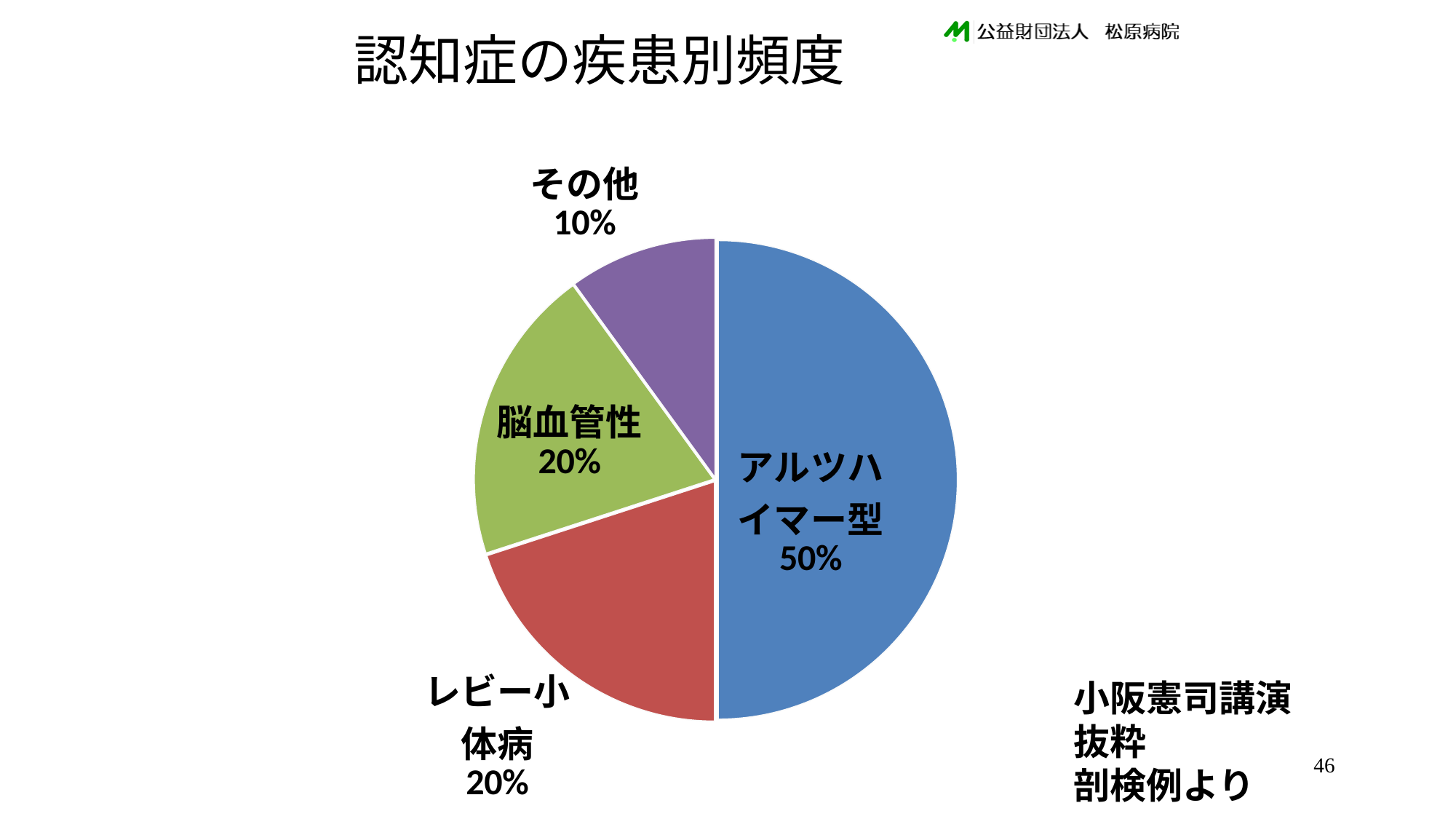
What kind of chart is shown on the slide? pie chart Which category has the smallest slice of the pie? その他 What is the difference between the values for レビー小体病 and その他? 10% Which is larger, the value for アルツハイマー型 or the value for その他? アルツハイマー型 Which category has the largest slice of the pie? アルツハイマー型 What is the value shown for 脳血管性? 20% How many categories are shown in the pie chart? 4 What share of the pie does アルツハイマー型 have? 50% What is the value shown for レビー小体病? 20% What is the value shown for その他? 10% What is the title of the chart on the slide? 認知症の疾患別頻度 What is the difference between the values for アルツハイマー型 and 脳血管性? 30%